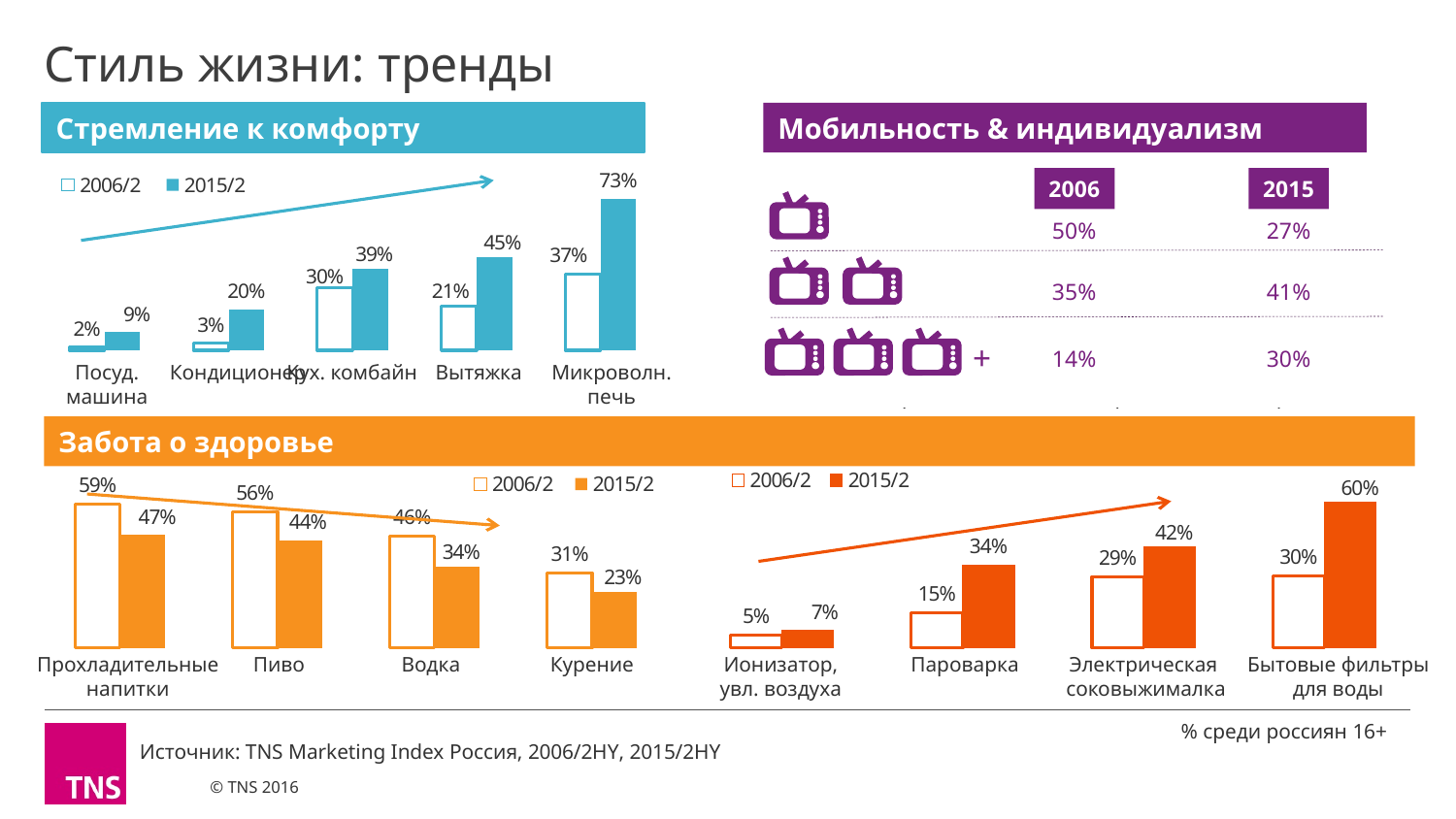
In the 'Стремление к комфорту' chart, what is the 2006/2 value for Вытяжка? 21% In the bottom-left chart under 'Забота о здоровье', what is the 2015/2 value for Пиво? 44% How many series does the legend list in the bottom-right chart under 'Забота о здоровье'? 2 How many categories are shown in the 'Стремление к комфорту' chart? 5 In the 'Стремление к комфорту' chart, what is the difference between the 2015/2 and 2006/2 values for Кондиционер? 17% In the bottom-right chart under 'Забота о здоровье', what is the 2015/2 value for Бытовые фильтры для воды? 60% In the bottom-left chart under 'Забота о здоровье', what is the difference between the 2006/2 and 2015/2 values for Курение? 8% In the bottom-left chart under 'Забота о здоровье', do the 2015/2 values rise or fall from left to right across the categories? fall In the 'Стремление к комфорту' chart, which category has the lowest 2006/2 value? Посуд. машина In the bottom-left chart under 'Забота о здоровье', which category has the highest 2006/2 value? Прохладительные напитки In the 'Стремление к комфорту' chart, what is the 2015/2 value for Микроволн. печь? 73% In the bottom-right chart under 'Забота о здоровье', which is larger: the 2015/2 value for Пароварка or the 2015/2 value for Электрическая соковыжималка? Электрическая соковыжималка